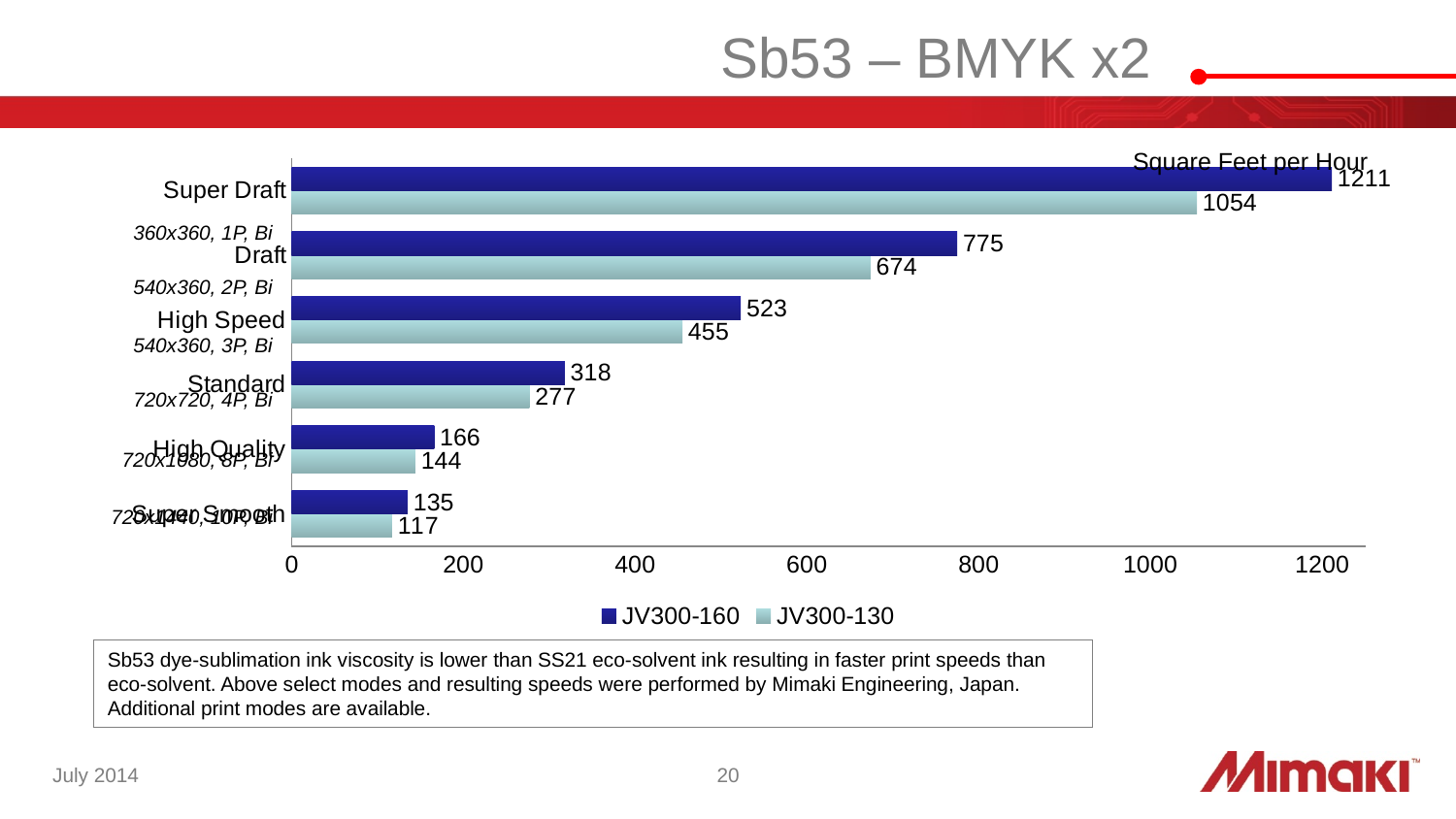
What is the JV300-160 value for Super Draft? 1211 What is the difference between the JV300-160 and JV300-130 values for Super Draft? 157 How many print modes are shown on the chart? 6 What is the JV300-130 value for Draft? 674 What is the JV300-160 value for High Speed? 523 What is the title of the chart? Square Feet per Hour Which print mode has the highest JV300-160 value? Super Draft How many series does the legend list? 2 Which is larger: the JV300-160 value for High Quality or the JV300-130 value for Standard? JV300-130 value for Standard Which print mode has the lowest JV300-130 value? Super Smooth What kind of chart is shown on the slide? Bar chart What is the JV300-130 value for Standard? 277